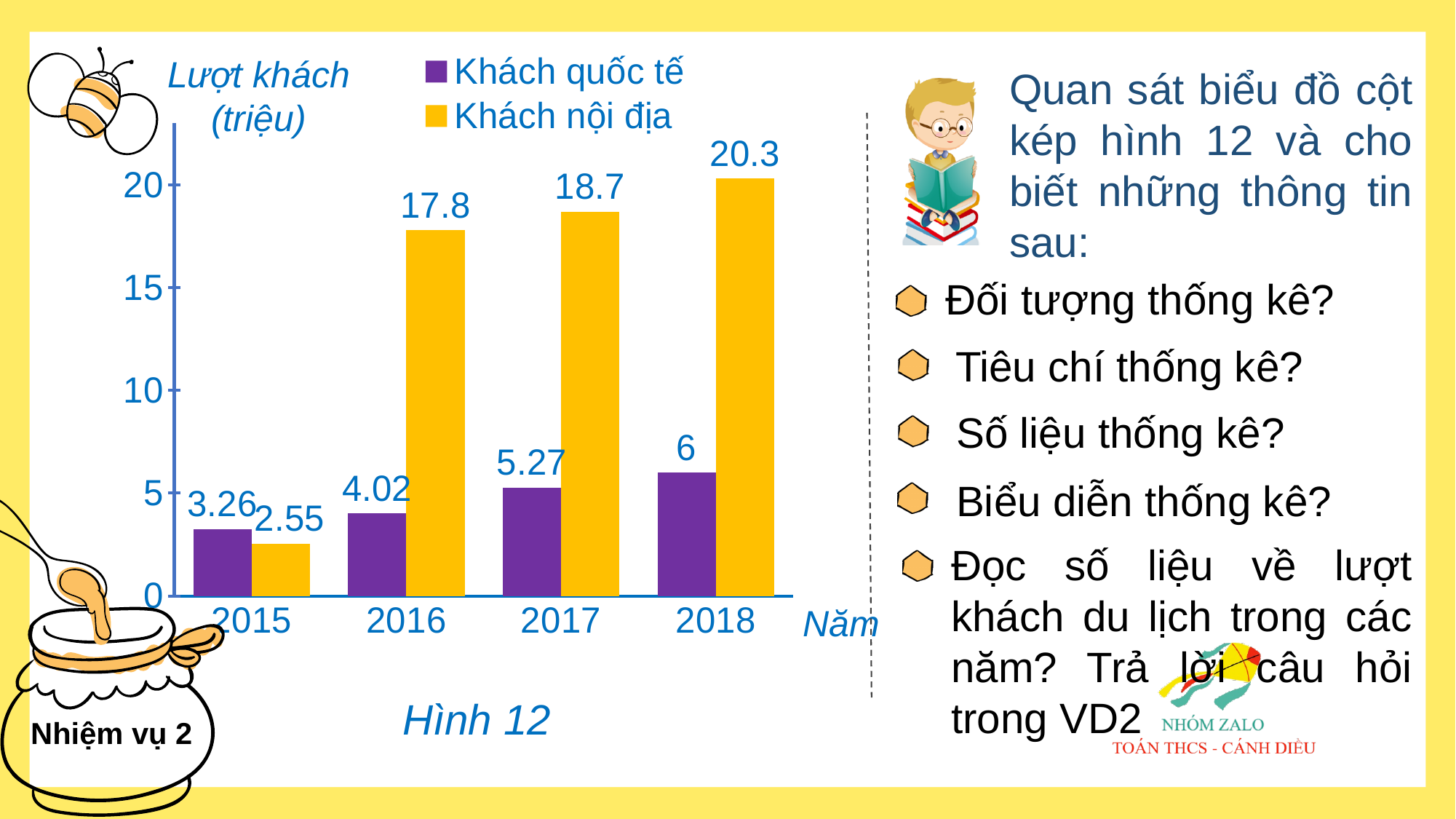
What kind of chart is shown? bar chart In which year is Khách quốc tế lowest? 2015 How many series does the legend list? 2 Is the value for Khách nội địa in 2017 greater or less than 15? greater What is the difference between Khách nội địa and Khách quốc tế in 2018? 14.3 What is the value for Khách nội địa in 2015? 2.55 What is the value for Khách quốc tế in 2017? 5.27 Do the values for Khách quốc tế rise or fall from 2015 to 2018? rise Which is larger in 2015, Khách quốc tế or Khách nội địa? Khách quốc tế In which year is Khách nội địa highest? 2018 What is the value for Khách nội địa in 2016? 17.8 How many years are shown on the x axis? 4